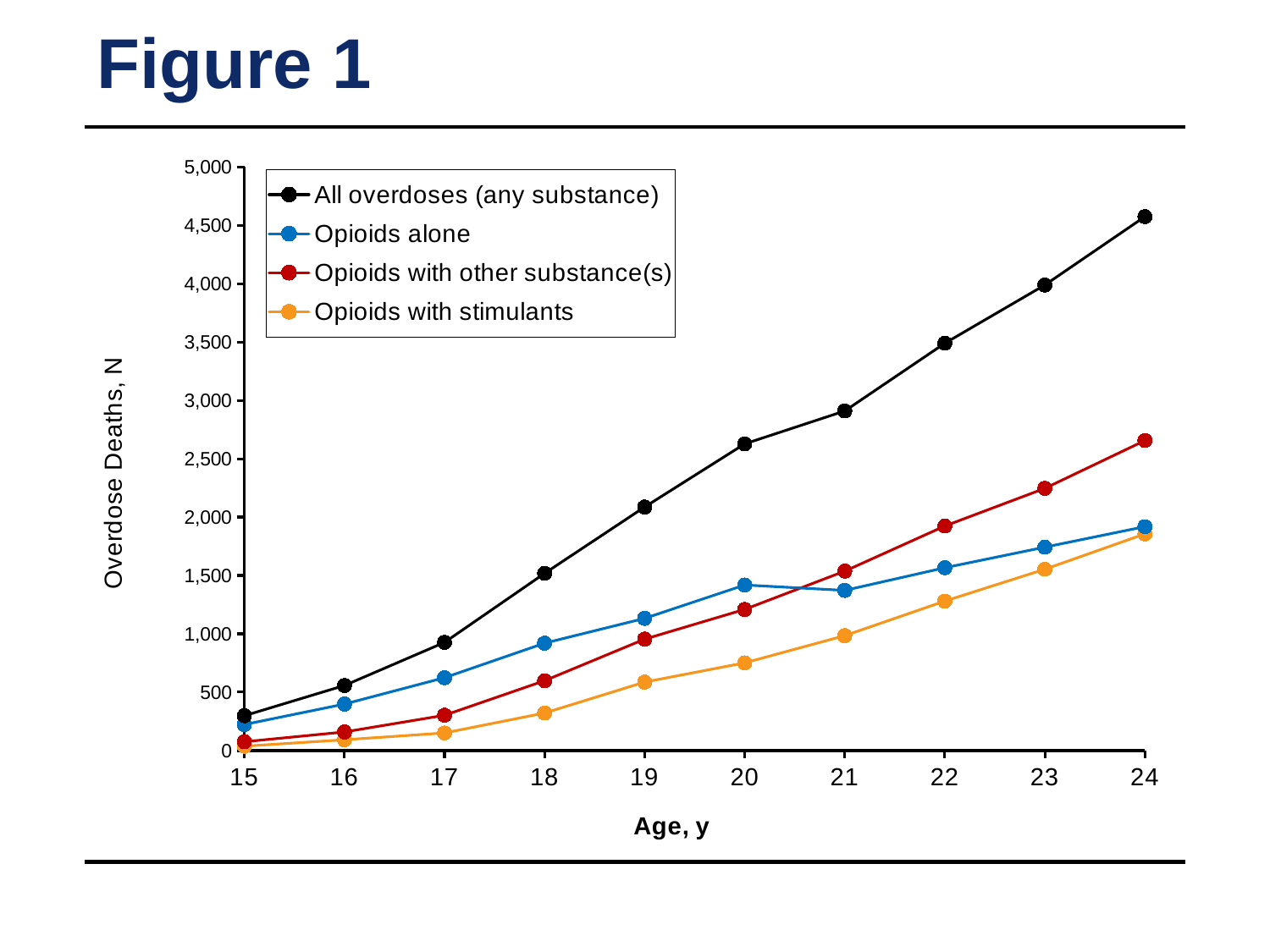
What is the label on the y axis? Overdose Deaths, N Is the value for Opioids alone at age 15 greater or less than 500? less Is the value for All overdoses (any substance) at age 24 greater or less than 4,000? greater How many series does the legend list? 4 Which series has the highest value at age 24? All overdoses (any substance) What kind of chart is shown on the slide? line chart Is the value for Opioids with other substance(s) at age 22 greater or less than 1,500? greater At age 20, which is larger: Opioids alone or Opioids with other substance(s)? Opioids alone Which series has the lowest value at age 24? Opioids with stimulants How many age points are plotted along the x axis? 10 Do the values for All overdoses (any substance) rise or fall as age increases from 15 to 24? rise